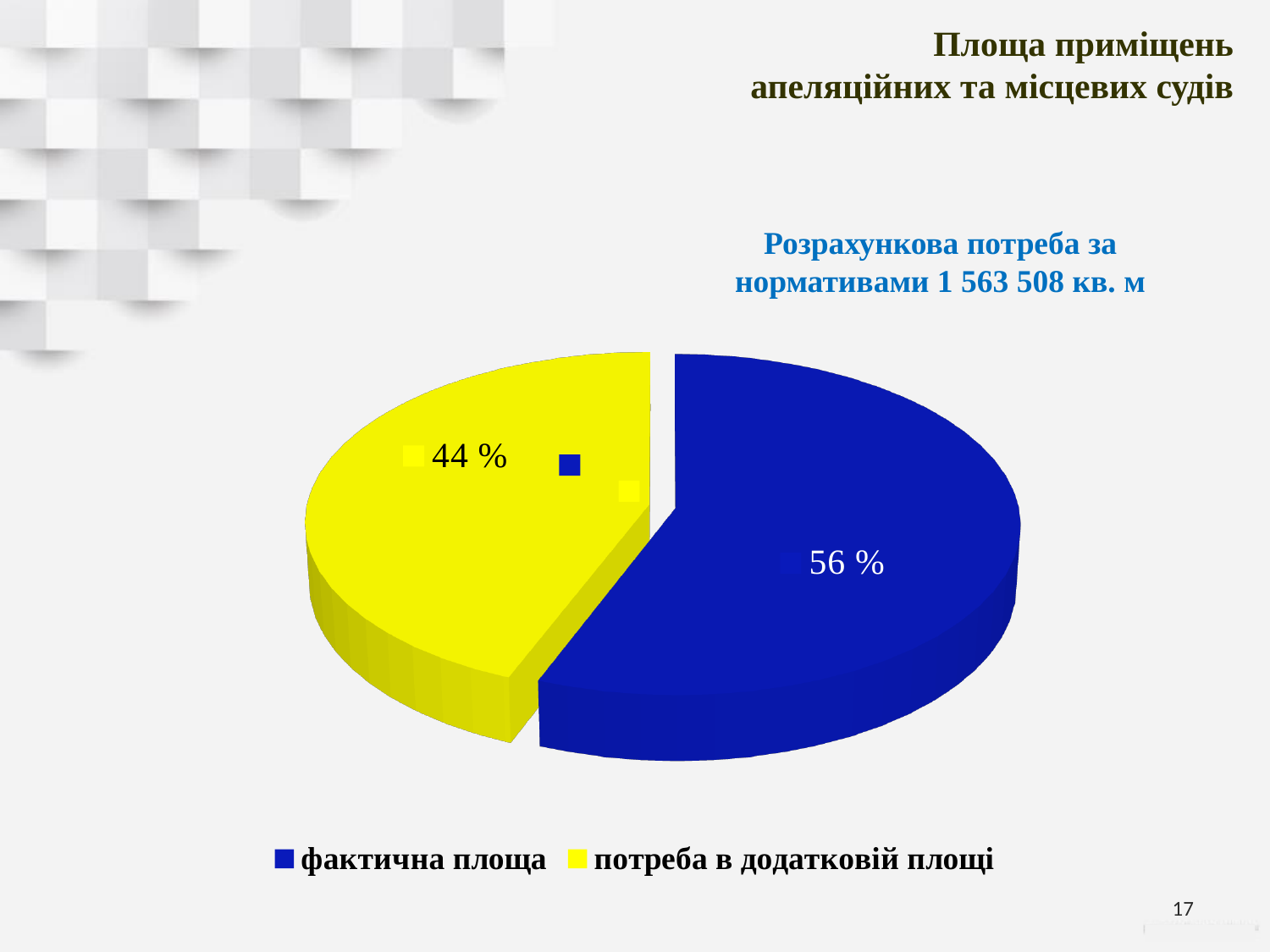
What kind of chart is shown on the slide? pie chart What colour is the "фактична площа" slice? blue What is the difference in percentage points between "фактична площа" and "потреба в додатковій площі"? 12 Which slice is the largest? фактична площа What share of the pie does "фактична площа" represent? 56 % What share of the pie does "потреба в додатковій площі" represent? 44 % How many entries does the legend list? 2 How many slices does the pie chart have? 2 What is the calculated need according to the standards stated above the chart? 1 563 508 кв. м Which slice is the smallest? потреба в додатковій площі Which is larger: "фактична площа" or "потреба в додатковій площі"? фактична площа